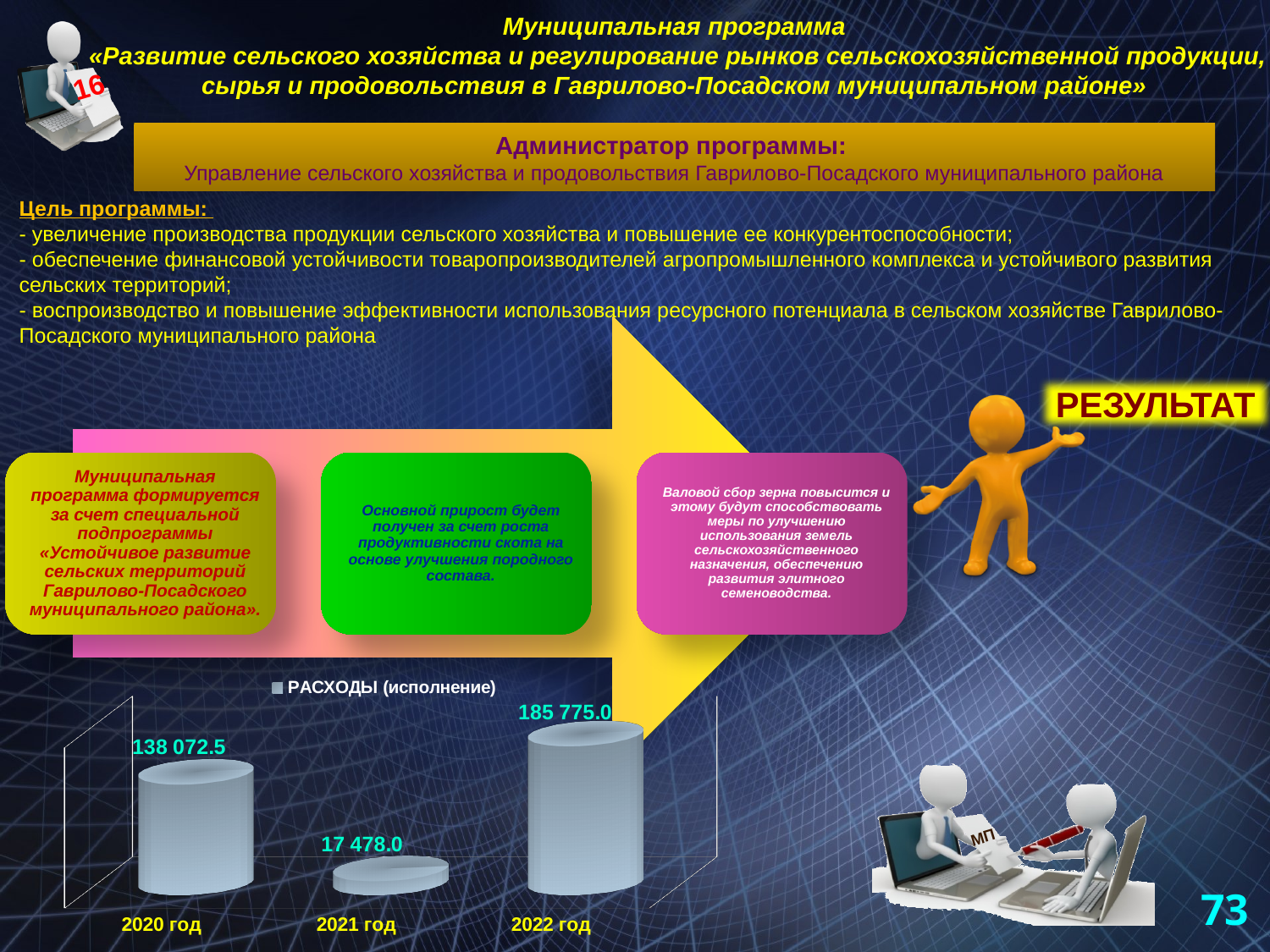
Which year has the highest value in the РАСХОДЫ (исполнение) chart? 2022 год Which year has the lowest value in the РАСХОДЫ (исполнение) chart? 2021 год What is the difference between the values for 2020 год and 2021 год in the РАСХОДЫ (исполнение) chart? 120 594.5 What kind of chart is shown at the bottom of the slide? Bar chart What is the value for 2020 год in the РАСХОДЫ (исполнение) chart? 138 072.5 Does the value rise or fall from 2021 год to 2022 год in the РАСХОДЫ (исполнение) chart? Rise What is the value for 2021 год in the РАСХОДЫ (исполнение) chart? 17 478.0 How many years are shown in the РАСХОДЫ (исполнение) chart? 3 What is the difference between the values for 2022 год and 2020 год in the РАСХОДЫ (исполнение) chart? 47 702.5 What is the value for 2022 год in the РАСХОДЫ (исполнение) chart? 185 775.0 How many series does the legend of the chart list? 1 In the РАСХОДЫ (исполнение) chart, which is larger: the value for 2020 год or 2022 год? 2022 год